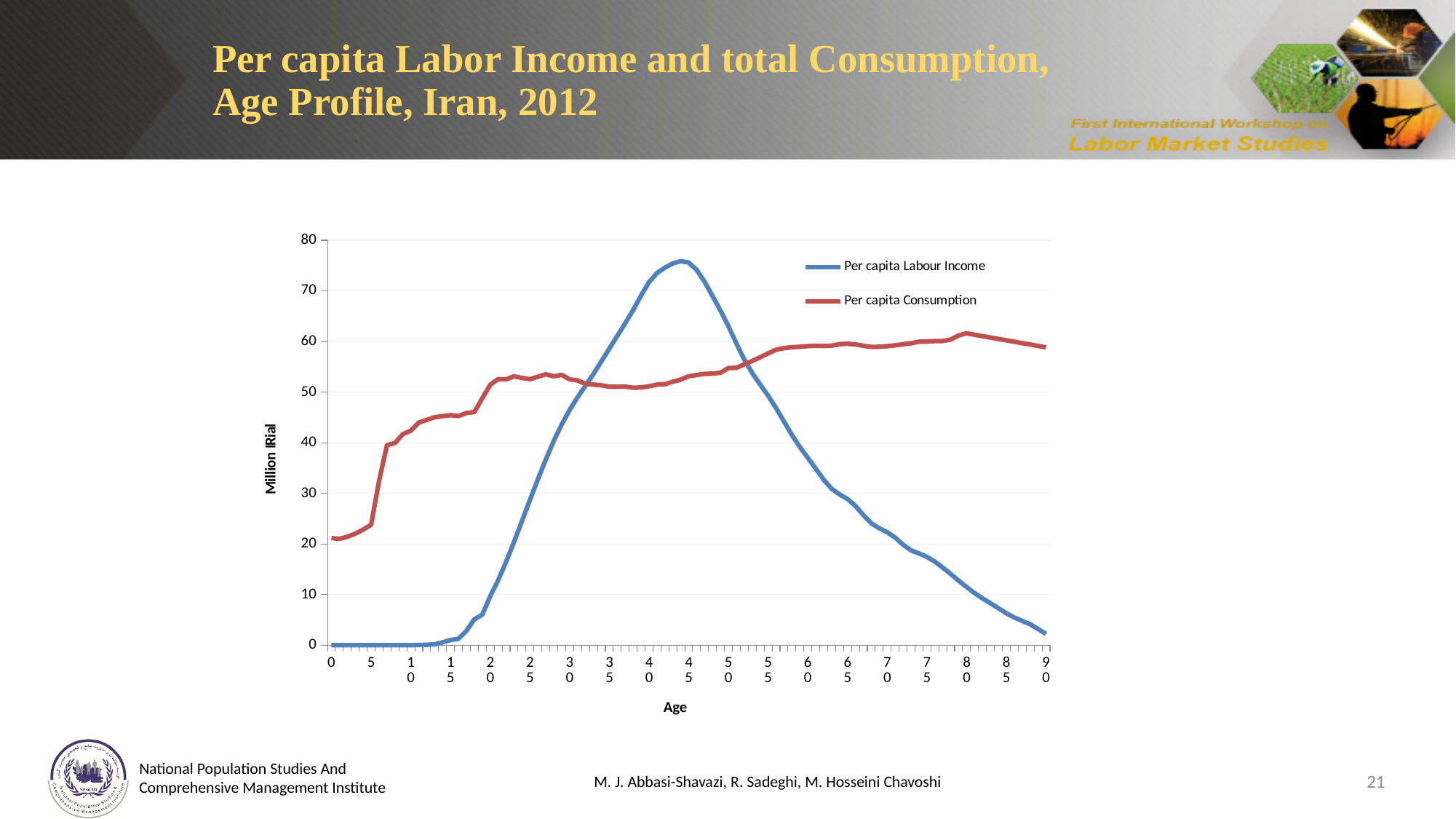
What is the label of the vertical axis? Million IRial Which series reaches the highest value anywhere on the chart? Per capita Labour Income Is the value of Per capita Consumption at age 10 greater or less than 40? greater Is the value of Per capita Consumption at age 30 greater or less than 50? greater What type of chart is shown on the slide? line chart Is the value of Per capita Labour Income at age 90 greater or less than 10? less At age 70, which series has the larger value, Per capita Labour Income or Per capita Consumption? Per capita Consumption How many series does the legend list? 2 Does Per capita Labour Income rise or fall between age 45 and age 90? fall At age 45, which series has the larger value, Per capita Labour Income or Per capita Consumption? Per capita Labour Income